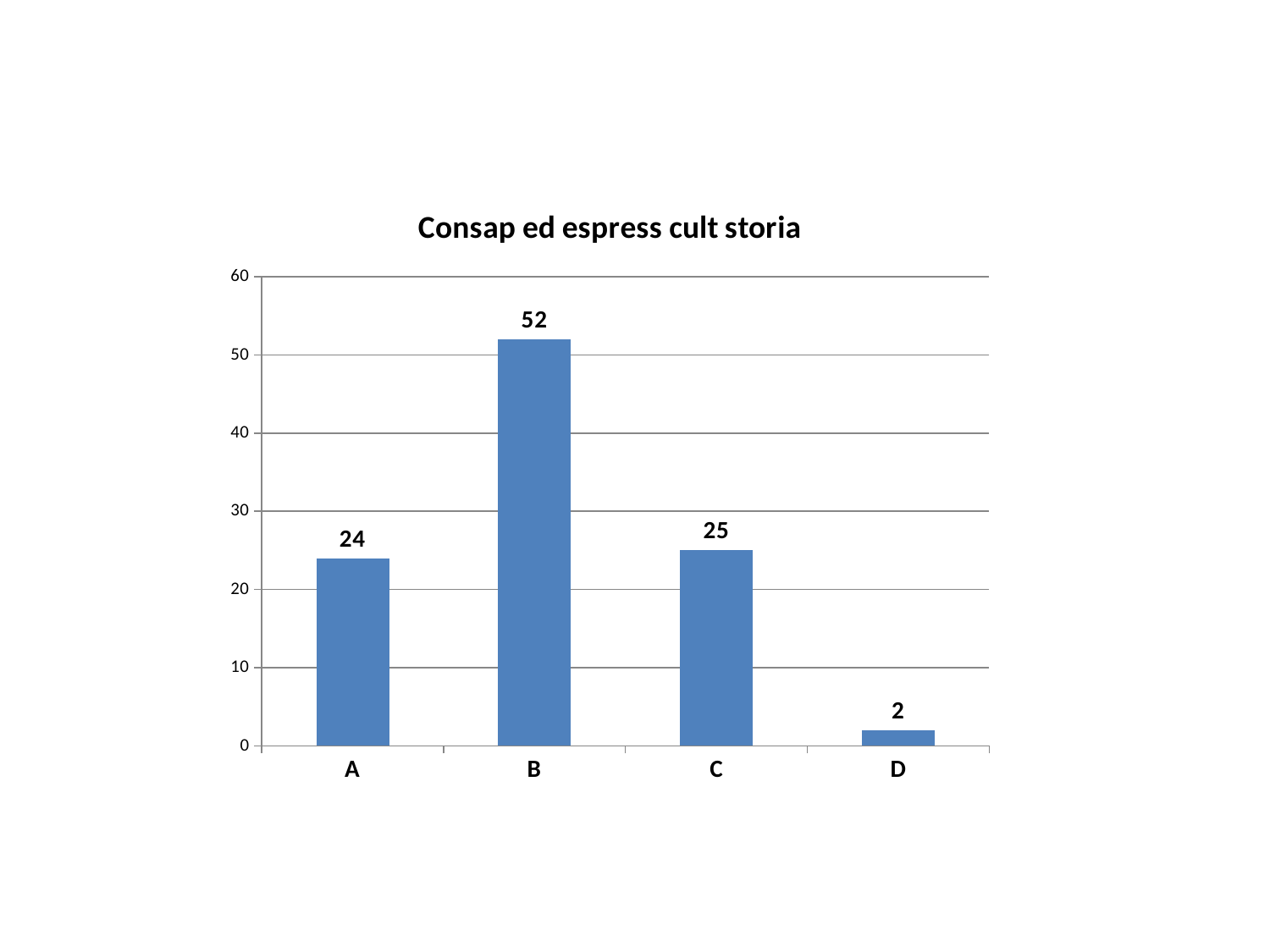
What is the value for category B? 52 Which is larger, the value for B or the value for A? B Is the value for C greater or less than 20? greater What is the difference between the values for A and D? 22 What is the value for category A? 24 How many categories are shown on the x axis? 4 Which category has the lowest value? D What is the difference between the values for B and C? 27 What kind of chart is shown on the slide? bar chart What is the value for category D? 2 Which category has the highest value? B What is the title of the chart? Consap ed espress cult storia